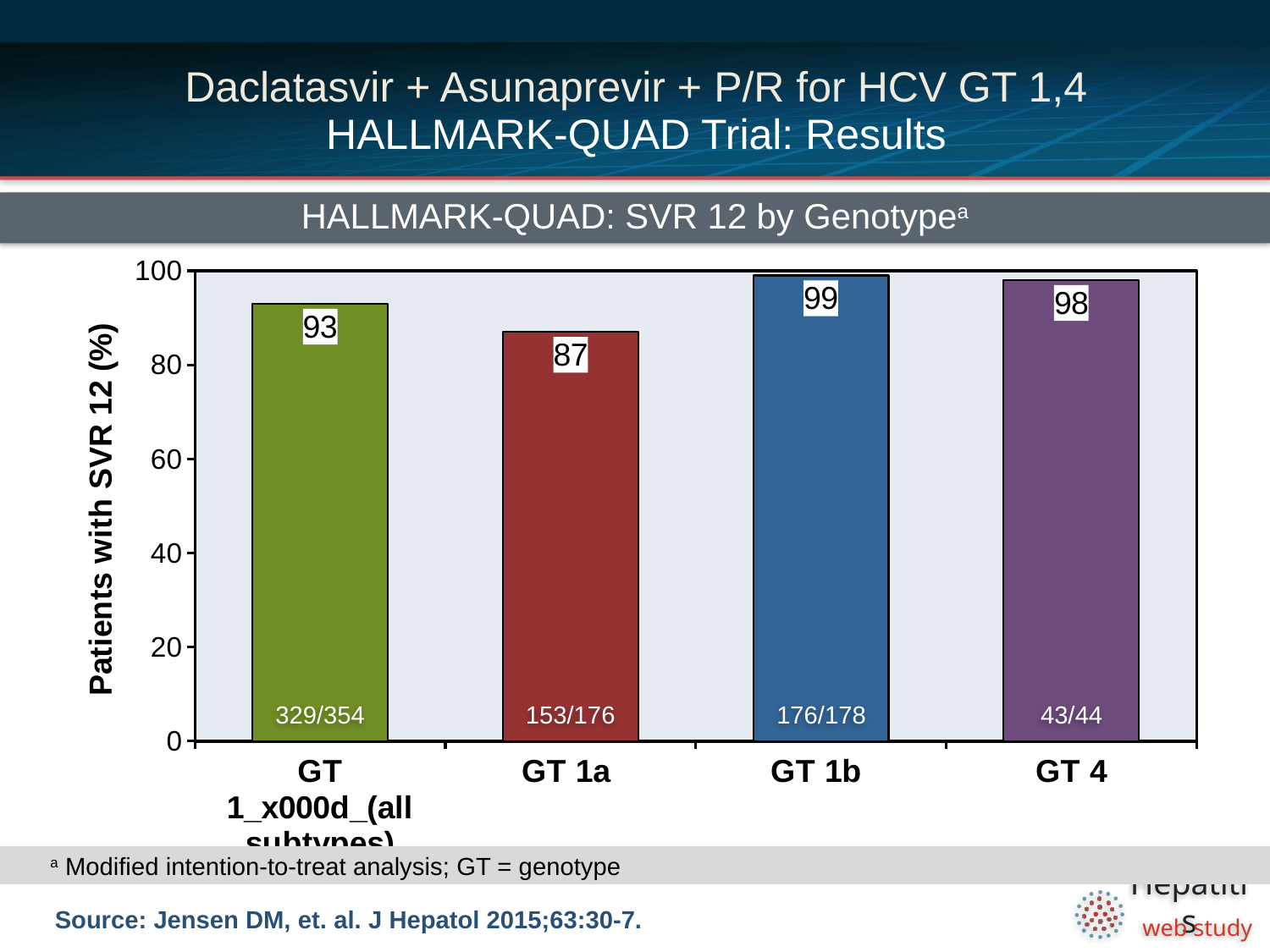
What patient fraction is printed on the GT 4 bar? 43/44 What patient fraction is printed on the GT 1b bar? 176/178 What is the SVR 12 value for GT 1b? 99 How many genotype categories are shown in the chart? 4 What is the SVR 12 value for GT 1a? 87 What is the SVR 12 value for GT 4? 98 What is the difference between the SVR 12 values for GT 1b and GT 1a? 12 Which genotype has the lowest SVR 12 value? GT 1a Which has a higher SVR 12 value, GT 4 or GT 1a? GT 4 What is the SVR 12 value for the leftmost bar, GT 1 (all subtypes)? 93 What kind of chart is shown on the slide? Bar chart Which genotype has the highest SVR 12 value? GT 1b